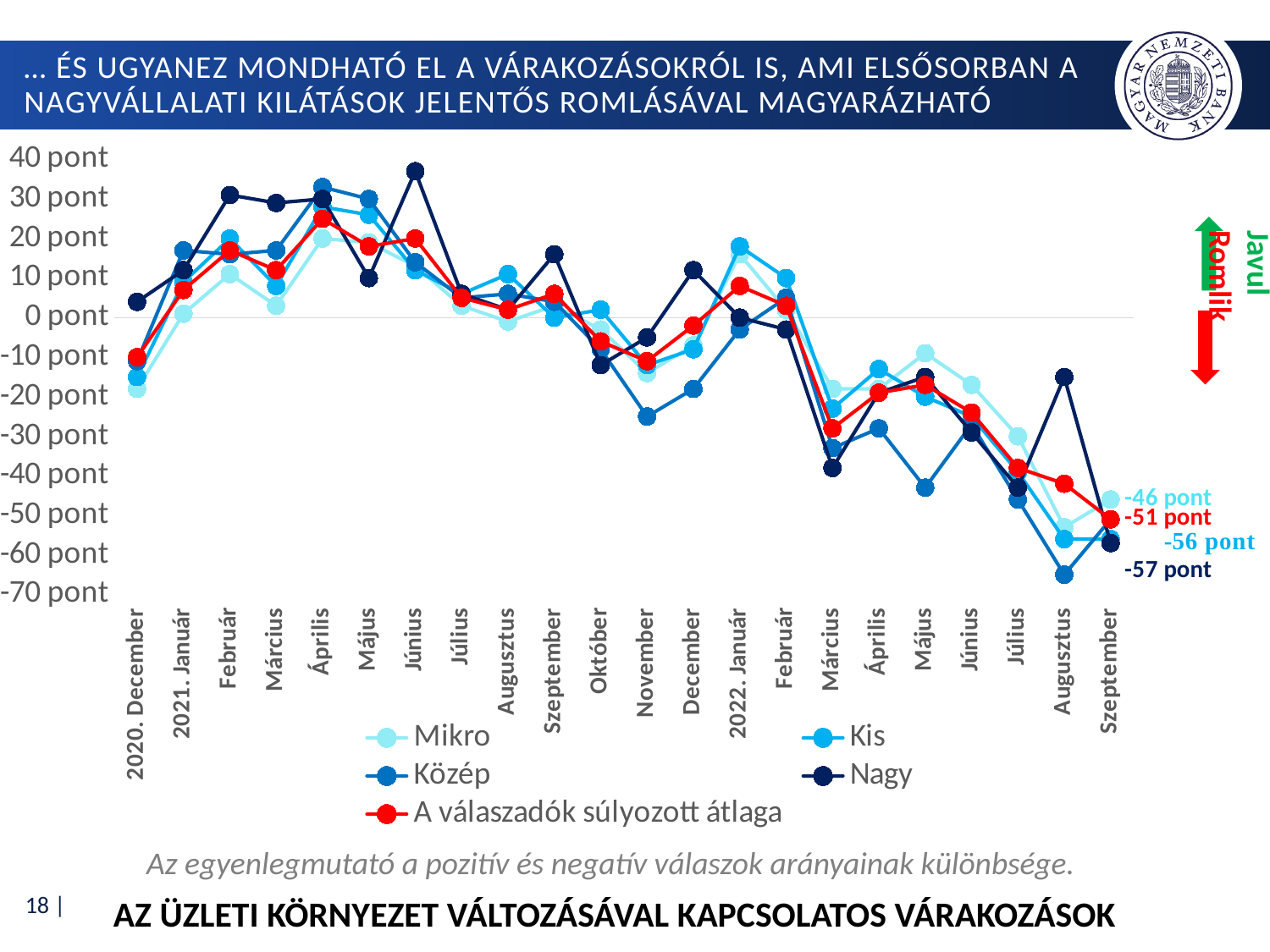
What kind of chart is shown on the slide? line chart Is the value of the Nagy series in Június 2021 greater or less than 30 pont? greater In Szeptember 2022, which is higher: the Mikro value or the Nagy value? Mikro How many series does the legend list? 5 What is the value of the Kis series in Szeptember 2022, as labelled at the end of the line? -56 pont What is the value of the Nagy series in Szeptember 2022, as labelled at the end of the line? -57 pont How many months (points) are shown along the x axis? 22 Do the series generally rise or fall from 2020. December to Szeptember 2022? fall What is the value of the Mikro series in Szeptember 2022, as labelled at the end of the line? -46 pont What is the difference between the Mikro value (-46 pont) and the Nagy value (-57 pont) in Szeptember 2022? 11 pont Which series is drawn in red in the legend? A válaszadók súlyozott átlaga What is the value of 'A válaszadók súlyozott átlaga' in Szeptember 2022, as labelled at the end of the line? -51 pont